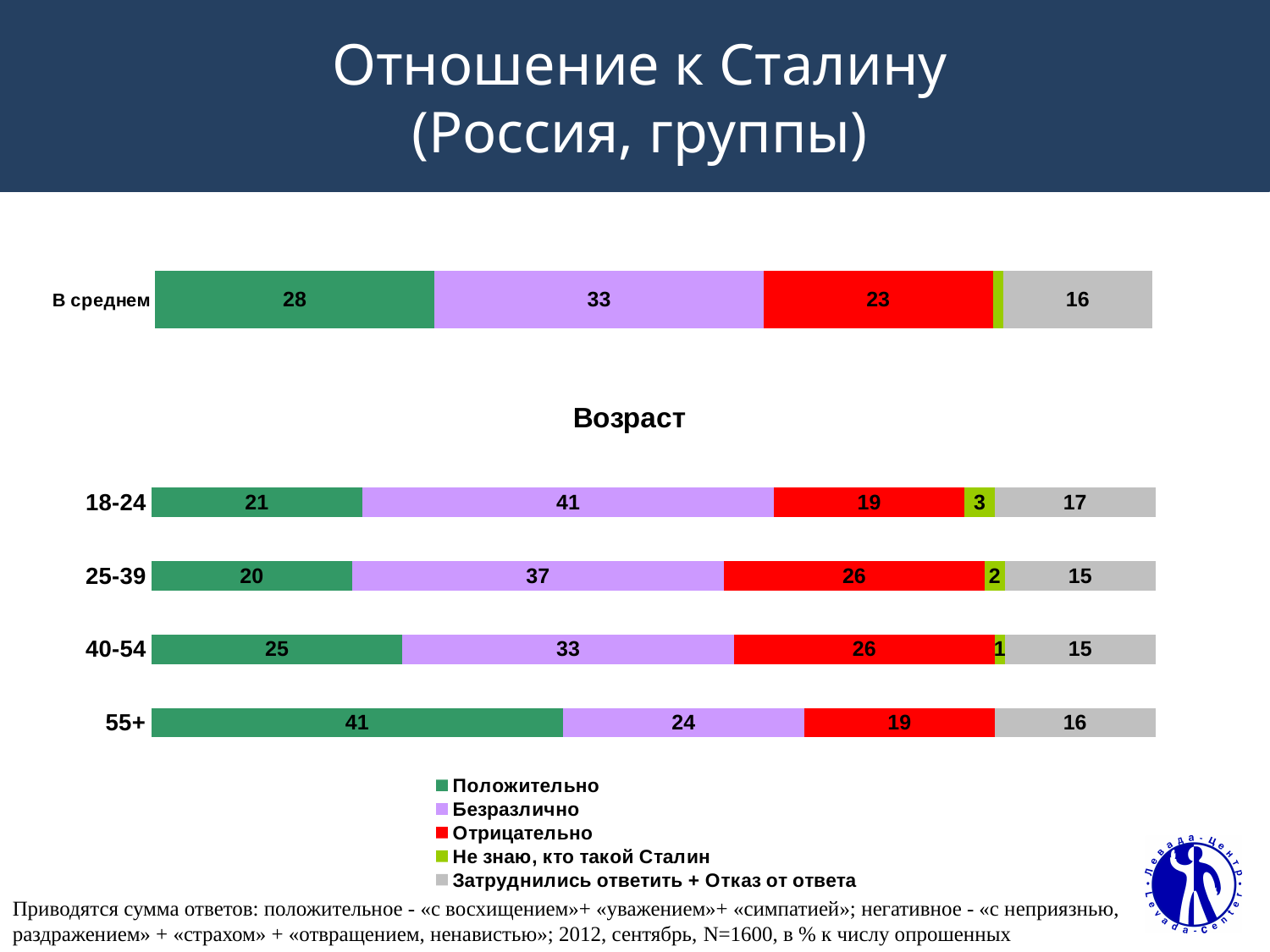
In the "Возраст" chart, what is the value for "Не знаю, кто такой Сталин" in the 25-39 group? 2 What kind of chart is the "Возраст" chart? Stacked bar chart In the "Возраст" chart, what colour represents "Отрицательно"? Red How many age groups are shown in the "Возраст" chart? 4 In the "Возраст" chart, what is the difference between the "Положительно" values for the 55+ and 18-24 groups? 20 In the "Возраст" chart, what is the value for "Безразлично" in the 18-24 group? 41 In the top chart ("В среднем"), what is the value for "Отрицательно"? 23 How many series does the legend list? 5 In the "Возраст" chart, which age group has the highest value for "Положительно"? 55+ In the "Возраст" chart, which is larger: "Отрицательно" for 25-39 or "Отрицательно" for 18-24? 25-39 In the "Возраст" chart, which age group has the lowest value for "Безразлично"? 55+ In the "Возраст" chart, what is the value for "Положительно" in the 55+ group? 41